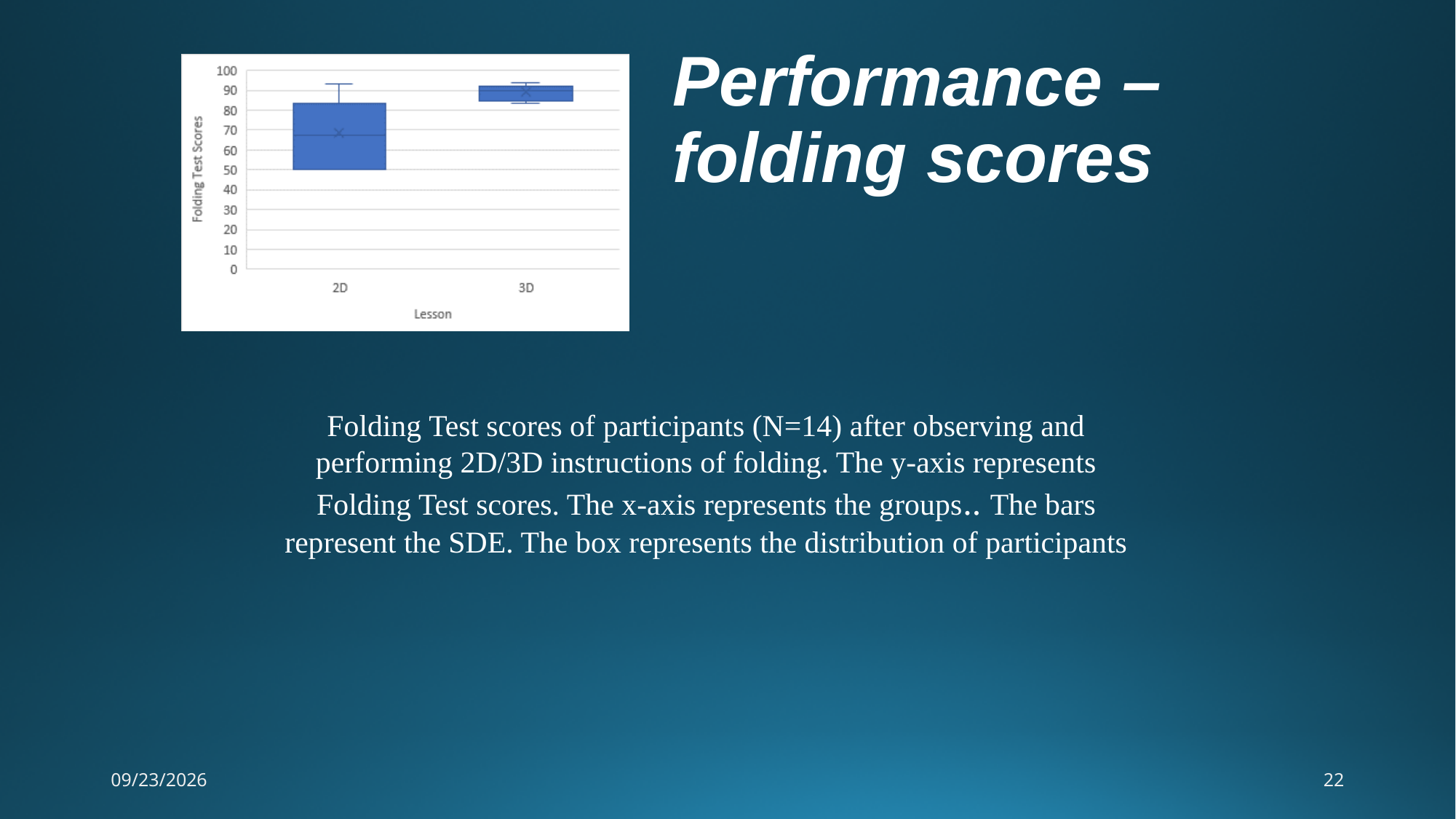
Is the top of the 2D box greater or less than 70? greater How many lesson categories are shown on the x axis of the chart? 2 What kind of chart is shown on the slide? Box-and-whisker plot Which lesson has the lower mean folding test score in the chart? 2D Which lesson shows the wider spread (taller box) of folding test scores? 2D What are the two categories on the x axis of the chart? 2D and 3D Is the mean marker for the 2D lesson greater or less than 80? less Which lesson has the higher mean marker (x) in the chart, 2D or 3D? 3D What is the label of the y axis of the chart? Folding Test Scores Is the bottom of the 3D box greater or less than 80? greater